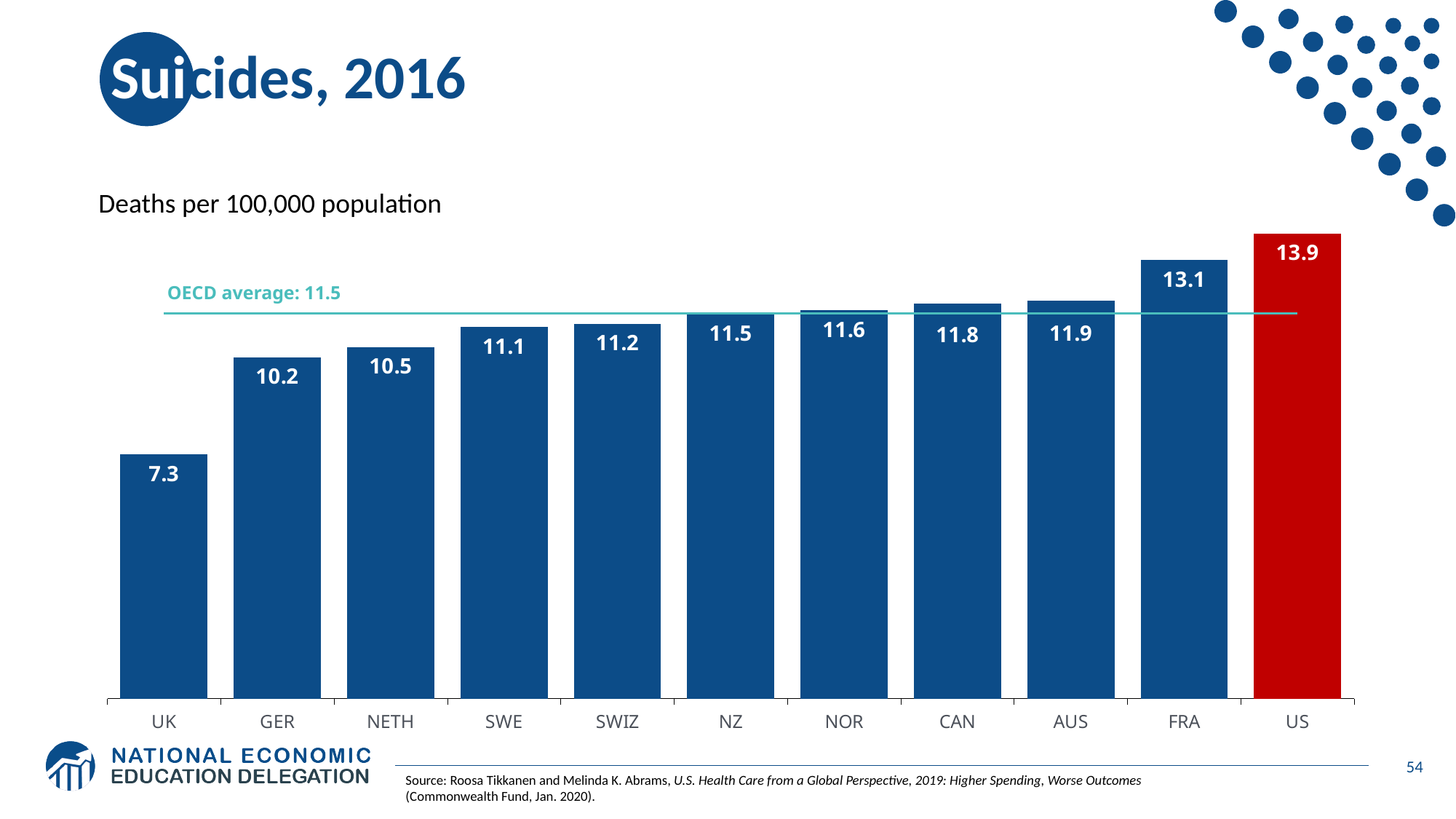
Do the values rise or fall from left to right across the chart? rise Which country has the lowest suicide rate on the chart? UK What is the value shown for GER? 10.2 What is the suicide rate shown for the US? 13.9 How many countries are shown on the chart? 11 What is the difference between the values for the US and the UK? 6.6 What is the difference between the values for FRA and AUS? 1.2 What kind of chart is shown on the slide? bar chart Which has a higher value, CAN or SWE? CAN What OECD average value is marked by the horizontal line on the chart? 11.5 What is the value shown for NOR? 11.6 Which country has the highest suicide rate on the chart? US